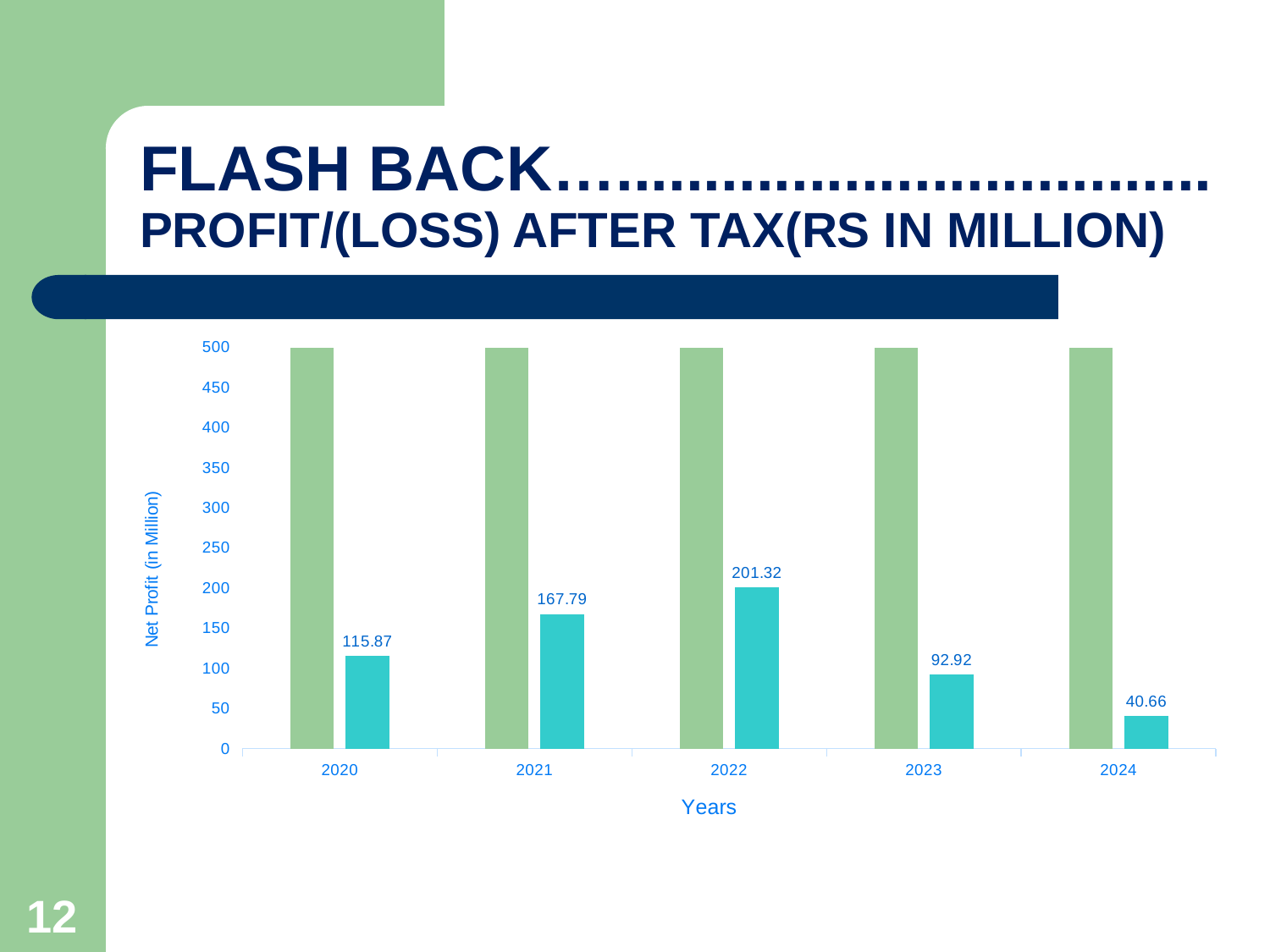
What kind of chart is shown on the slide? Bar chart What is the difference between the labelled net profit values for 2022 and 2023? 108.4 Do the labelled net profit values rise or fall from 2022 to 2024? Fall Which year has a larger labelled net profit value, 2021 or 2023? 2021 What is the net profit value shown for 2020? 115.87 Which year has the lowest labelled net profit value? 2024 What is the title of the vertical axis of the chart? Net Profit (in Million) Is the labelled net profit value for 2021 greater or less than 150? greater What is the net profit value shown for 2022? 201.32 Which year has the highest labelled net profit value? 2022 What is the net profit value shown for 2024? 40.66 How many years are shown on the x axis of the chart? 5